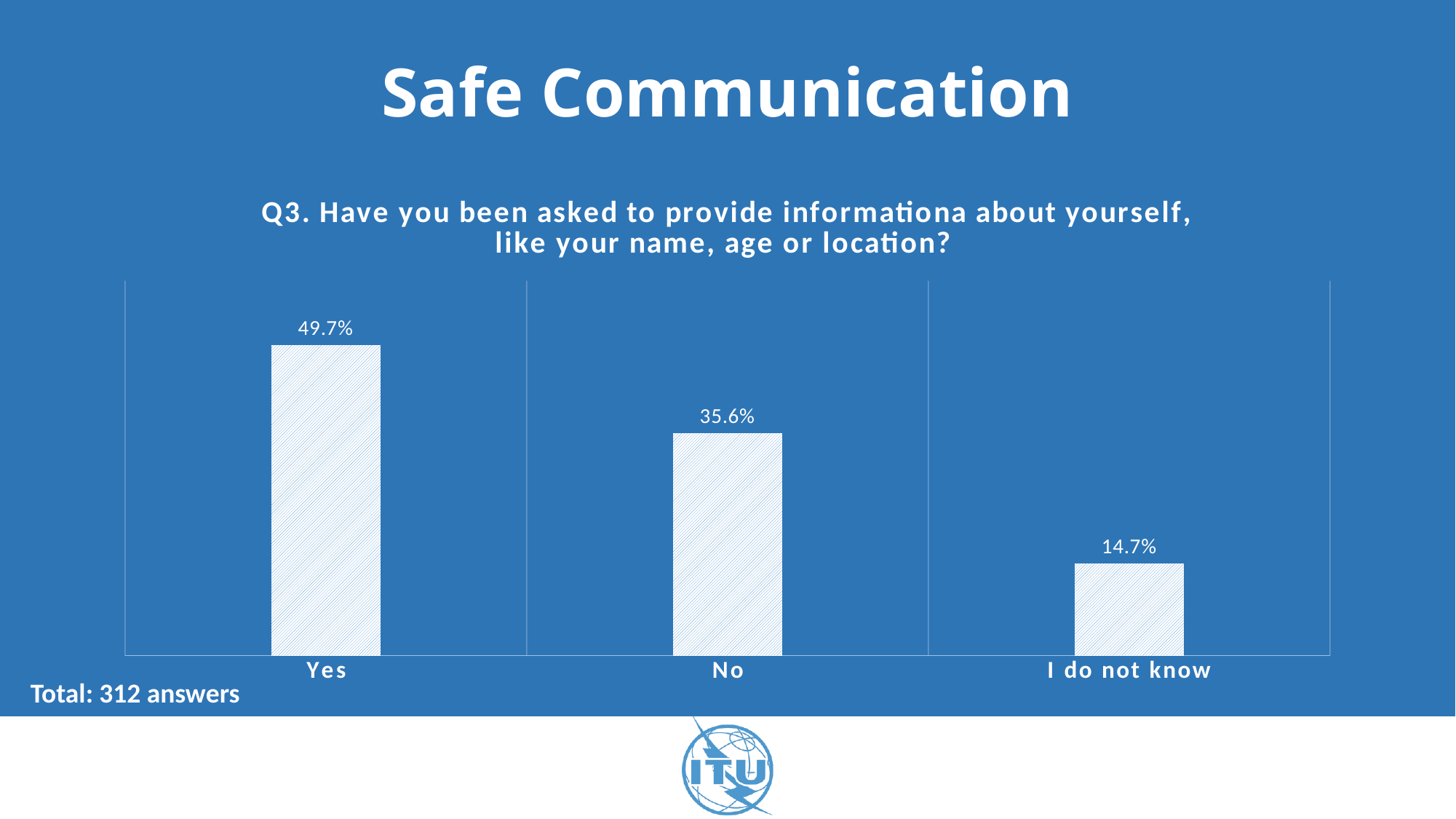
Which is larger, the value for "No" or the value for "I do not know"? No What kind of chart is shown on the slide? Bar chart Which answer category has the lowest percentage? I do not know What percentage of respondents answered "I do not know"? 14.7% What percentage of respondents answered "Yes"? 49.7% What is the difference in percentage points between "Yes" and "No"? 14.1 How many total answers does the slide say the chart is based on? 312 answers What percentage of respondents answered "No"? 35.6% Do the values rise or fall from left to right across the categories? Fall What is the difference in percentage points between "No" and "I do not know"? 20.9 Which answer category has the highest percentage? Yes How many answer categories are shown in the chart? 3